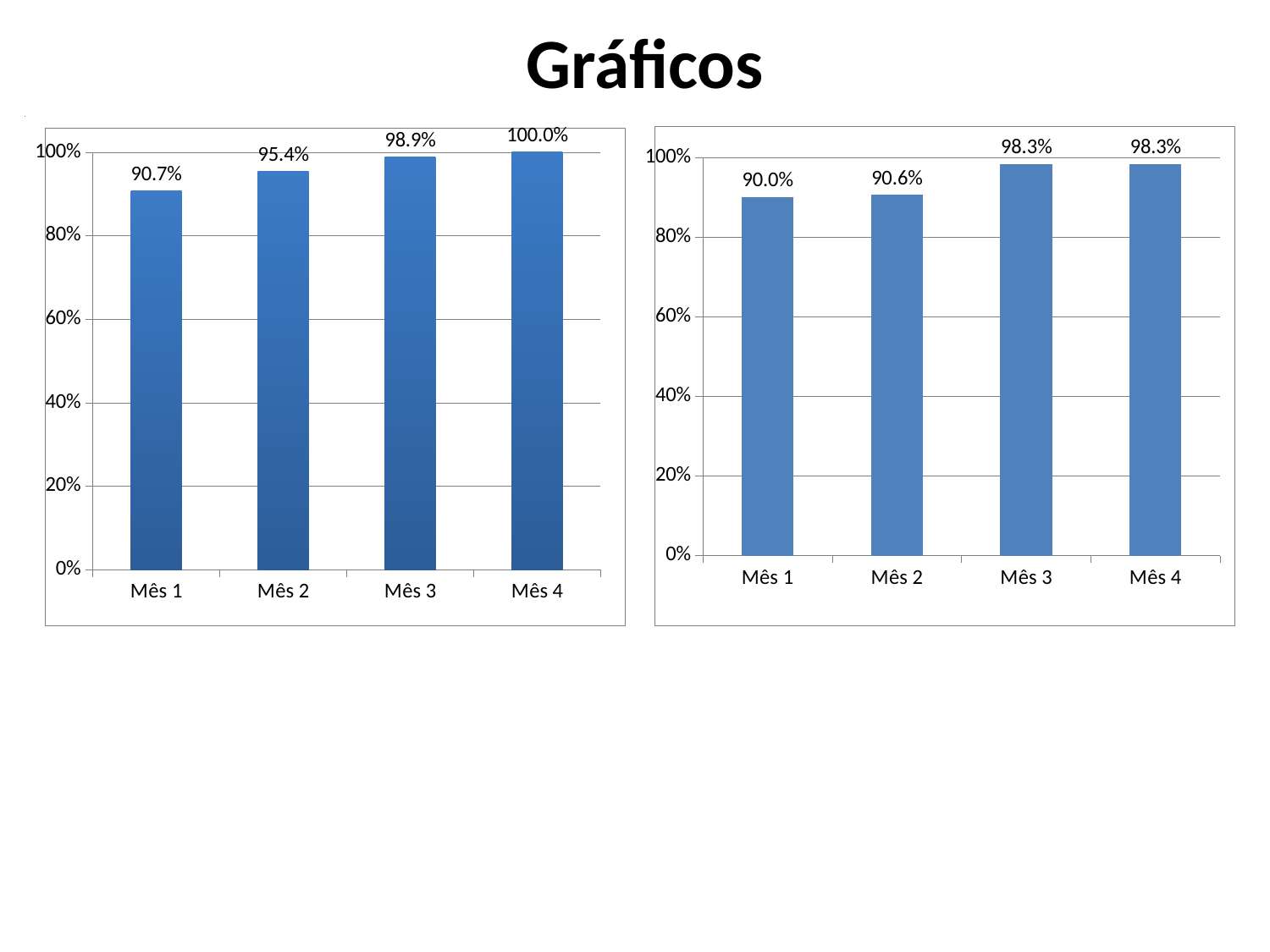
In the left chart, which month has the highest value? Mês 4 In the right chart, what is the difference between the values for Mês 3 and Mês 2? 7.7% In the left chart, do the values rise or fall from Mês 1 to Mês 4? Rise In the right chart, what is the value for Mês 2? 90.6% In the left chart, what is the value for Mês 3? 98.9% In the left chart, what is the value for Mês 1? 90.7% In the right chart, which month has the lowest value? Mês 1 In the right chart, what is the value for Mês 4? 98.3% In the left chart, which is larger, the value for Mês 2 or the value for Mês 3? Mês 3 How many bars are plotted in the right chart? 4 What kind of chart is the left chart? Bar chart In the left chart, what is the difference between the values for Mês 4 and Mês 1? 9.3%